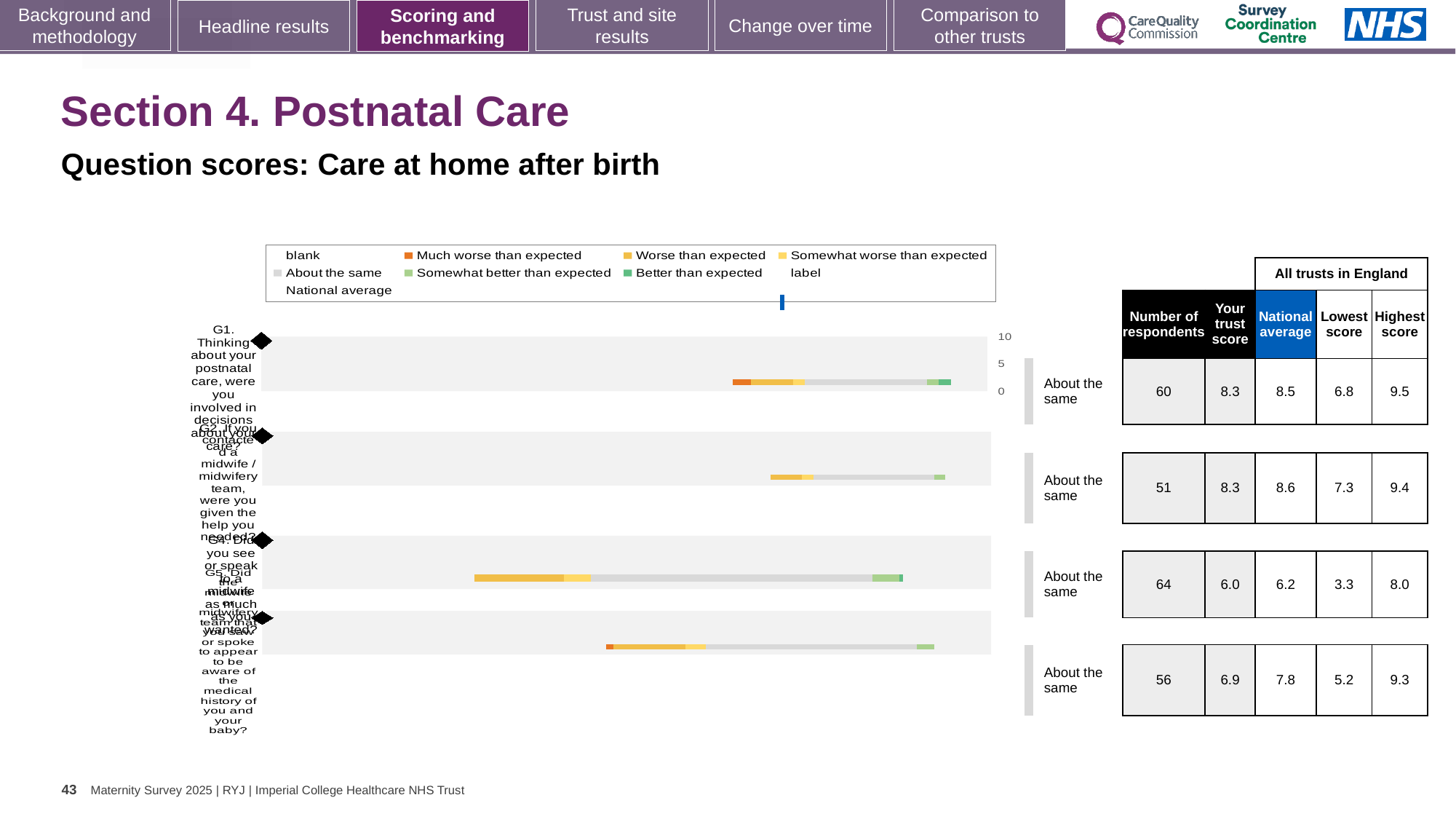
What is the lowest score among all trusts in England for G4? 3.3 What is the difference between the highest score and the lowest score for G2 (If you contacted a midwife / midwifery team, were you given the help you needed?)? 2.1 Which question has the lowest trust score? G4 For G1, which is larger: the trust score or the national average? National average How is the trust's result for each of the four questions rated relative to expectations? About the same What is the trust score for G1 (Thinking about your postnatal care, were you involved in decisions about your care?)? 8.3 What type of chart is used to show the question scores for care at home after birth? bar chart How many more respondents answered G4 than G2? 13 How many respondents answered G4 (Did you see or speak to a midwife as much as you wanted?)? 64 Which question has the highest 'Highest score' among all trusts in England? G1 What is the national average score for G5 (Did the midwife or midwifery team appear to be aware of the medical history of you and your baby?)? 7.8 How many questions (categories) are plotted in the chart? 4